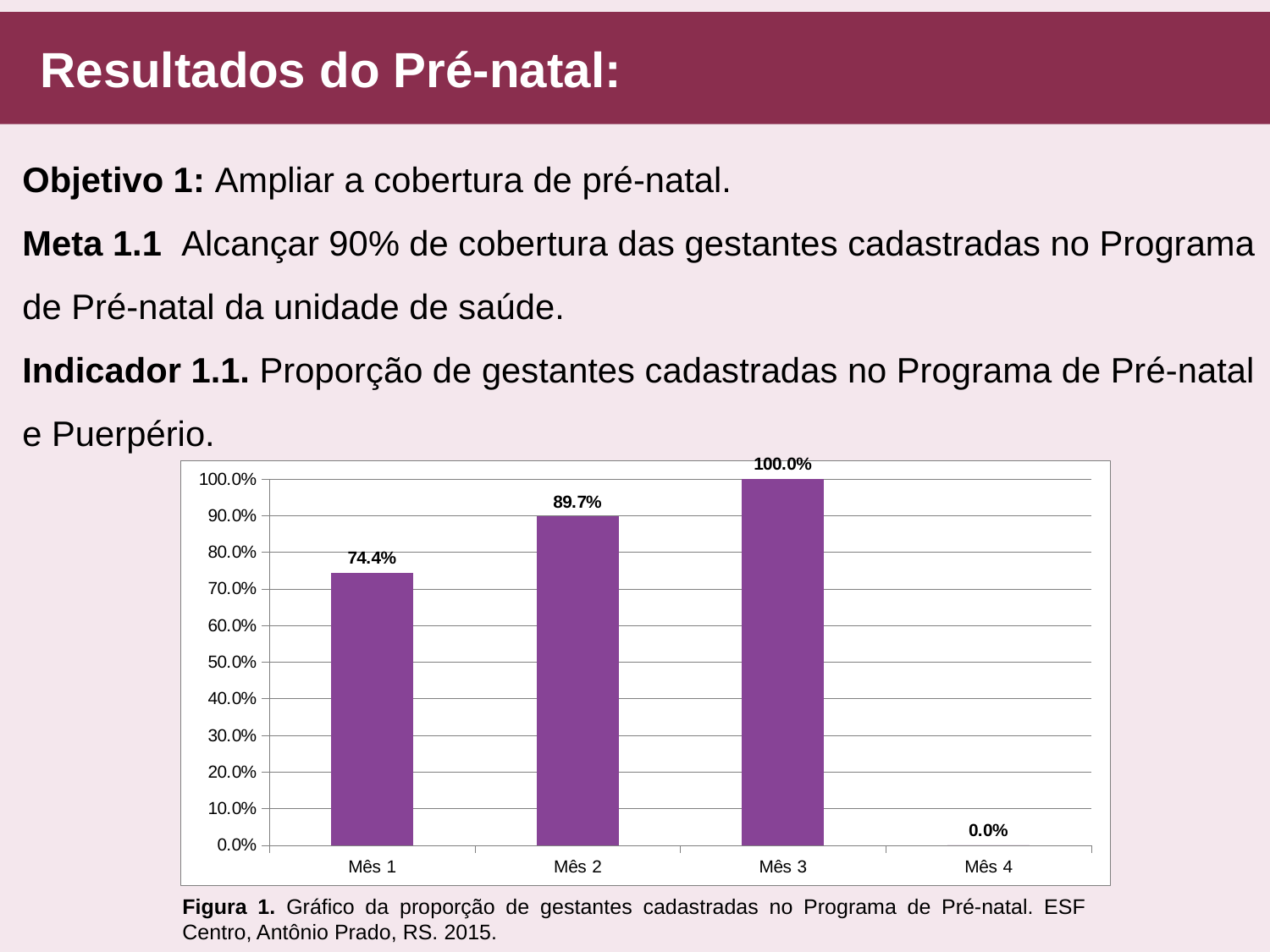
What is the value for Mês 4? 0.0% What kind of chart is shown on the slide? Bar chart What is the value for Mês 3? 100.0% What is the value for Mês 2? 89.7% Which month has the lowest value? Mês 4 Which month has the highest value? Mês 3 Which is larger, the value for Mês 1 or the value for Mês 2? Mês 2 What is the difference between the values for Mês 2 and Mês 1? 15.3% Is the value for Mês 1 greater or less than 70.0%? greater What is the difference between the values for Mês 3 and Mês 2? 10.3% How many months are shown on the x axis? 4 What is the value for Mês 1? 74.4%